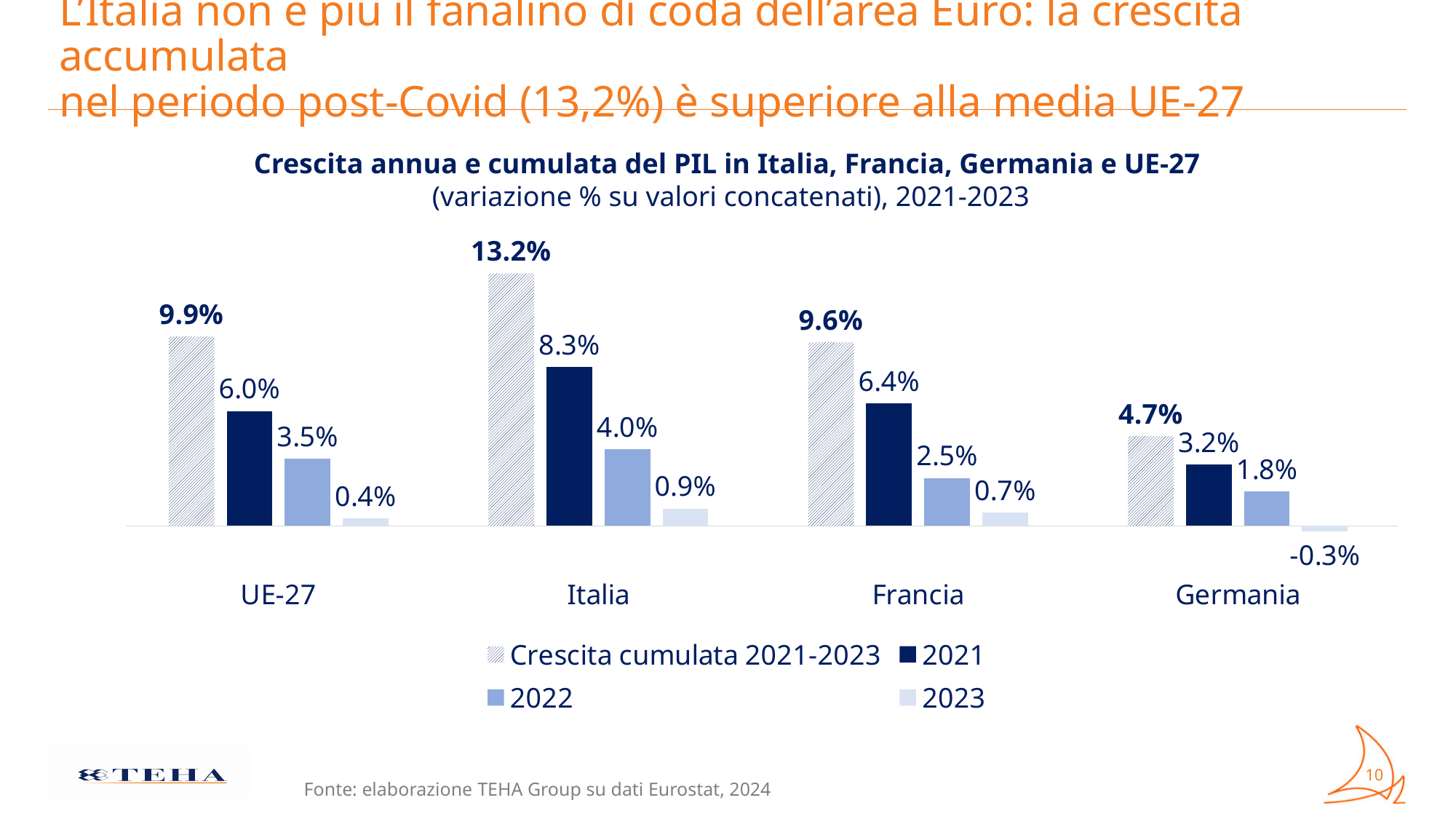
How many categories are shown on the x axis? 4 What is the 2023 value for Germania? -0.3% What is the title of the chart? Crescita annua e cumulata del PIL in Italia, Francia, Germania e UE-27 What is the difference between the cumulative growth 2021-2023 of Italia and UE-27? 3.3% What is the 2021 value for Francia? 6.4% Which category has the lowest 2021 value? Germania Which is larger, the 2022 value for Italia or the 2022 value for Francia? Italia How many series does the legend list? 4 What is the 2022 value for UE-27? 3.5% What kind of chart is shown on the slide? Bar chart What is the cumulative growth 2021-2023 (Crescita cumulata) for Italia? 13.2% Which category has the highest cumulative growth 2021-2023? Italia